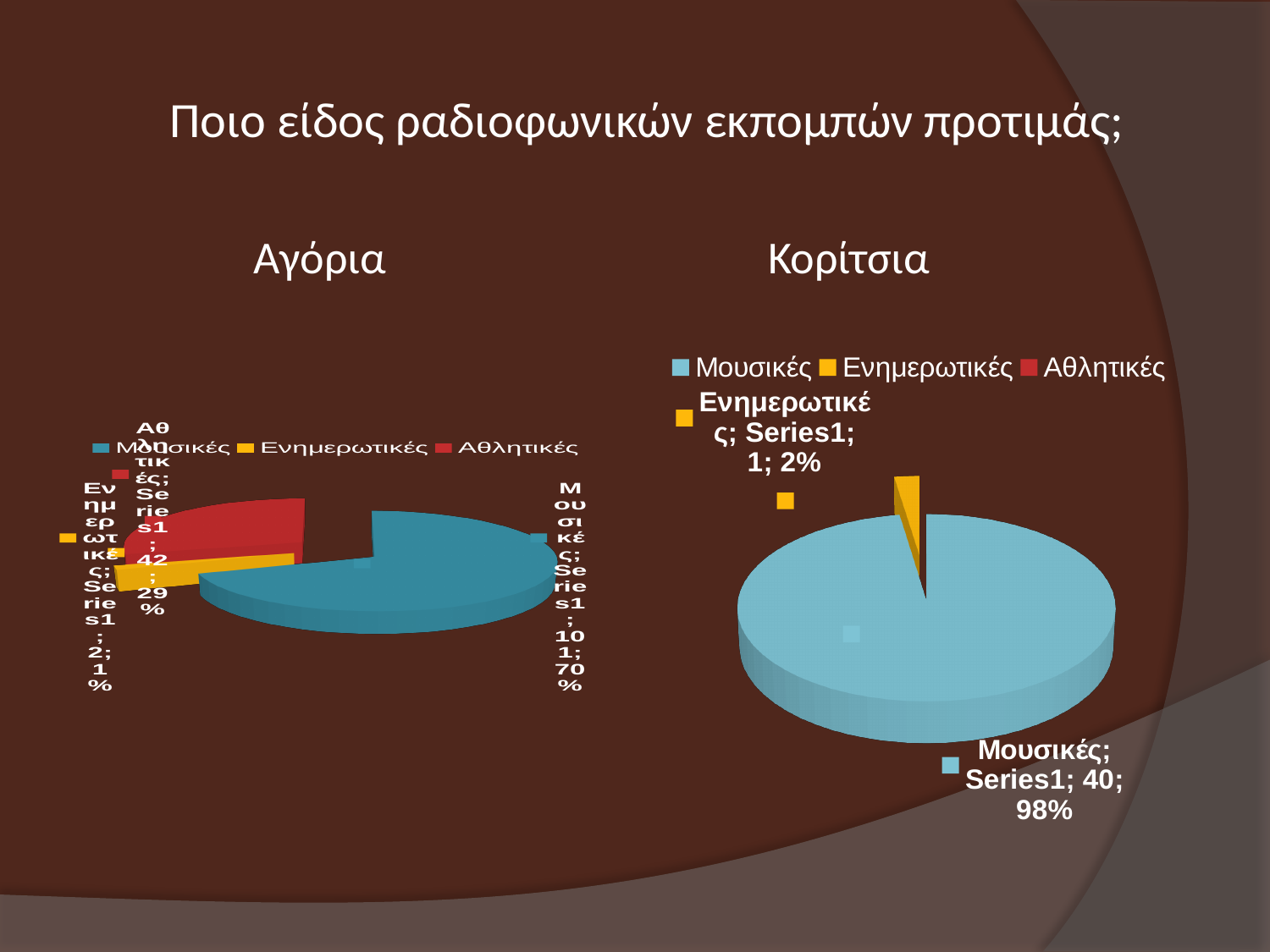
In the Αγόρια chart, what percentage share does Αθλητικές have? 29% In the Αγόρια chart, what value is shown for Μουσικές? 101 What kind of chart is used for the Αγόρια (boys) data? pie chart In the Αγόρια chart, which category has the largest slice? Μουσικές In the Αγόρια chart, what value is shown for Ενημερωτικές? 2 In the Αγόρια chart, what is the difference between the values for Μουσικές and Αθλητικές? 59 In the Κορίτσια chart, which is larger, Μουσικές or Ενημερωτικές? Μουσικές What is the title of the slide above the two charts? Ποιο είδος ραδιοφωνικών εκπομπών προτιμάς; In the Κορίτσια chart, what percentage share does Ενημερωτικές have? 2% In the Αγόρια chart, which category has the smallest slice? Ενημερωτικές How many entries does the legend of the Κορίτσια chart list? 3 In the Κορίτσια chart, what value is shown for Μουσικές? 40